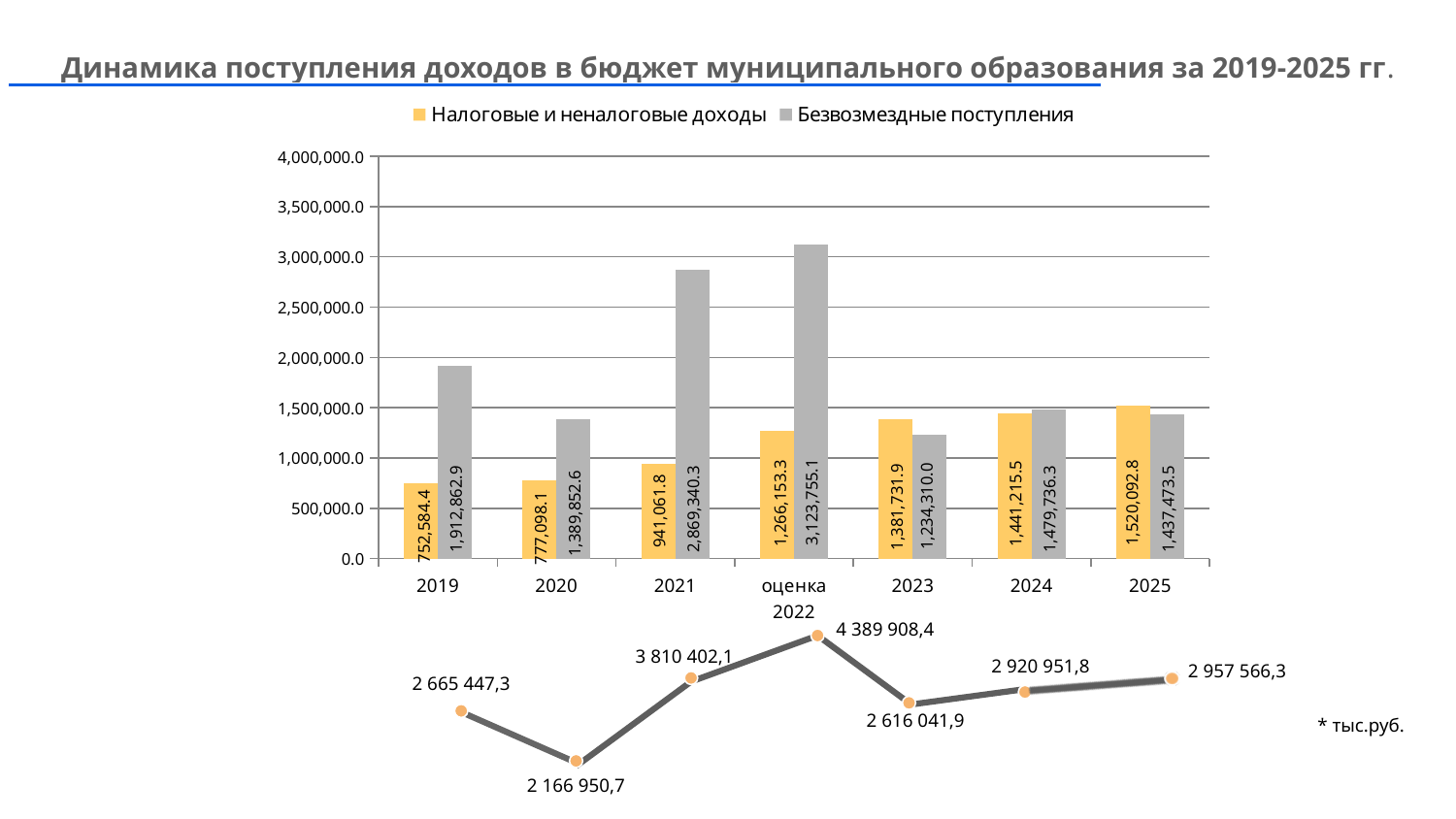
In the bar chart, what is the value of Безвозмездные поступления for оценка 2022? 3,123,755.1 In the bar chart, what is the value of Безвозмездные поступления for 2023? 1,234,310.0 How many categories are shown on the x axis of the bar chart? 7 In the line chart at the bottom of the slide, what is the value of the lowest point? 2 166 950,7 What kind of chart is the top chart on the slide? bar chart In the line chart at the bottom of the slide, what is the value of the highest point? 4 389 908,4 How many series does the legend of the bar chart list? 2 In the bar chart, which is larger for 2025: Налоговые и неналоговые доходы or Безвозмездные поступления? Налоговые и неналоговые доходы In the bar chart, which year has the highest value of Безвозмездные поступления? оценка 2022 In the bar chart, which year has the lowest value of Налоговые и неналоговые доходы? 2019 In the bar chart, what is the value of Налоговые и неналоговые доходы for 2019? 752,584.4 In the bar chart, is the value of Безвозмездные поступления for 2021 greater or less than 2,500,000.0? greater